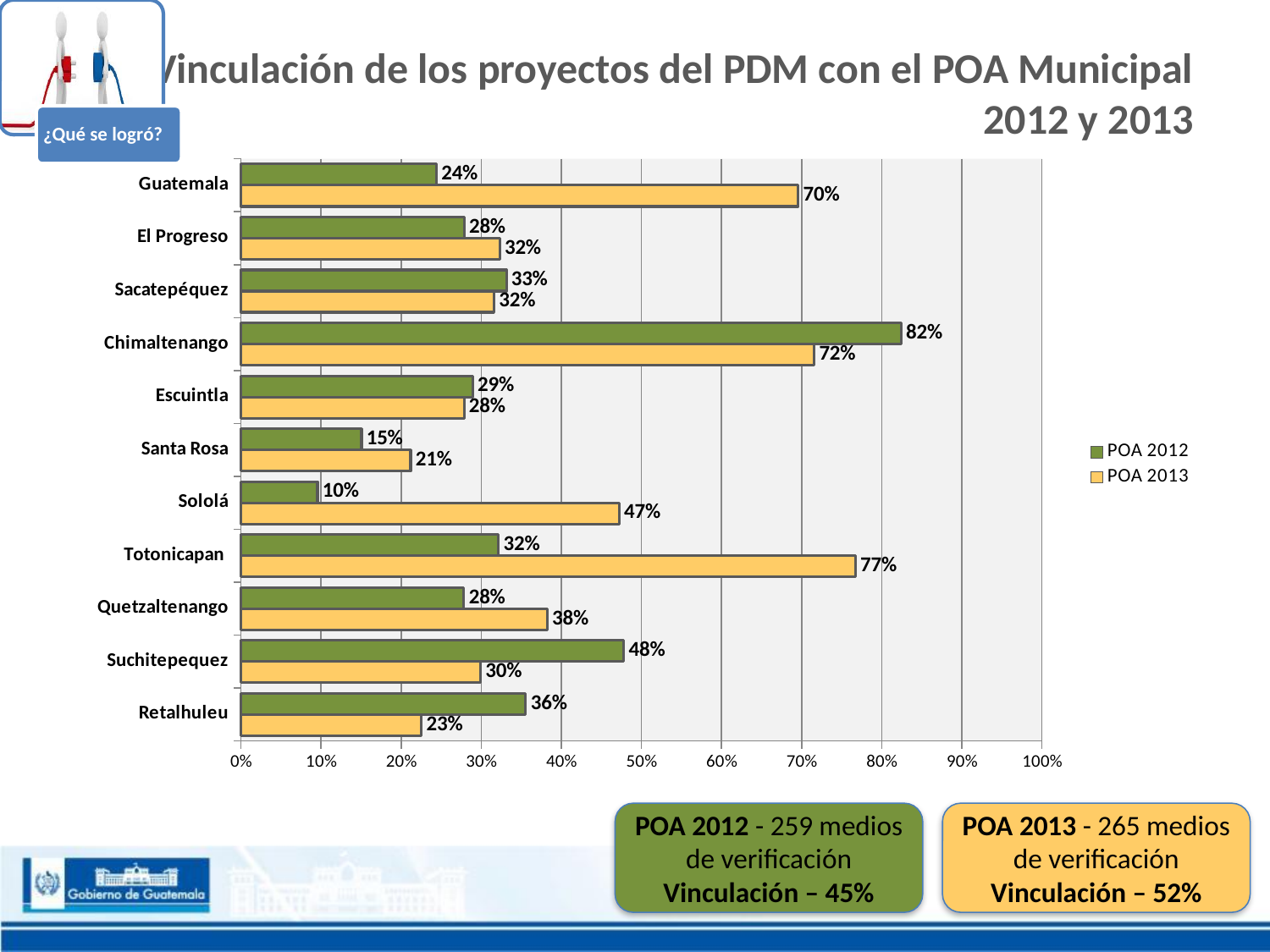
Which department has the highest POA 2013 value? Totonicapan What kind of chart is shown on the slide? Bar chart What is the POA 2013 value for Sololá? 47% Which is larger for Suchitepequez, the POA 2012 value or the POA 2013 value? POA 2012 What is the difference between the POA 2013 and POA 2012 values for Guatemala? 46% How many departments are shown on the chart? 11 Which colour represents POA 2013 in the chart? Yellow What is the POA 2012 value for Chimaltenango? 82% How many series does the legend list? 2 What is the POA 2013 value for Guatemala? 70% Which department has the lowest POA 2012 value? Sololá Which department has the highest POA 2012 value? Chimaltenango